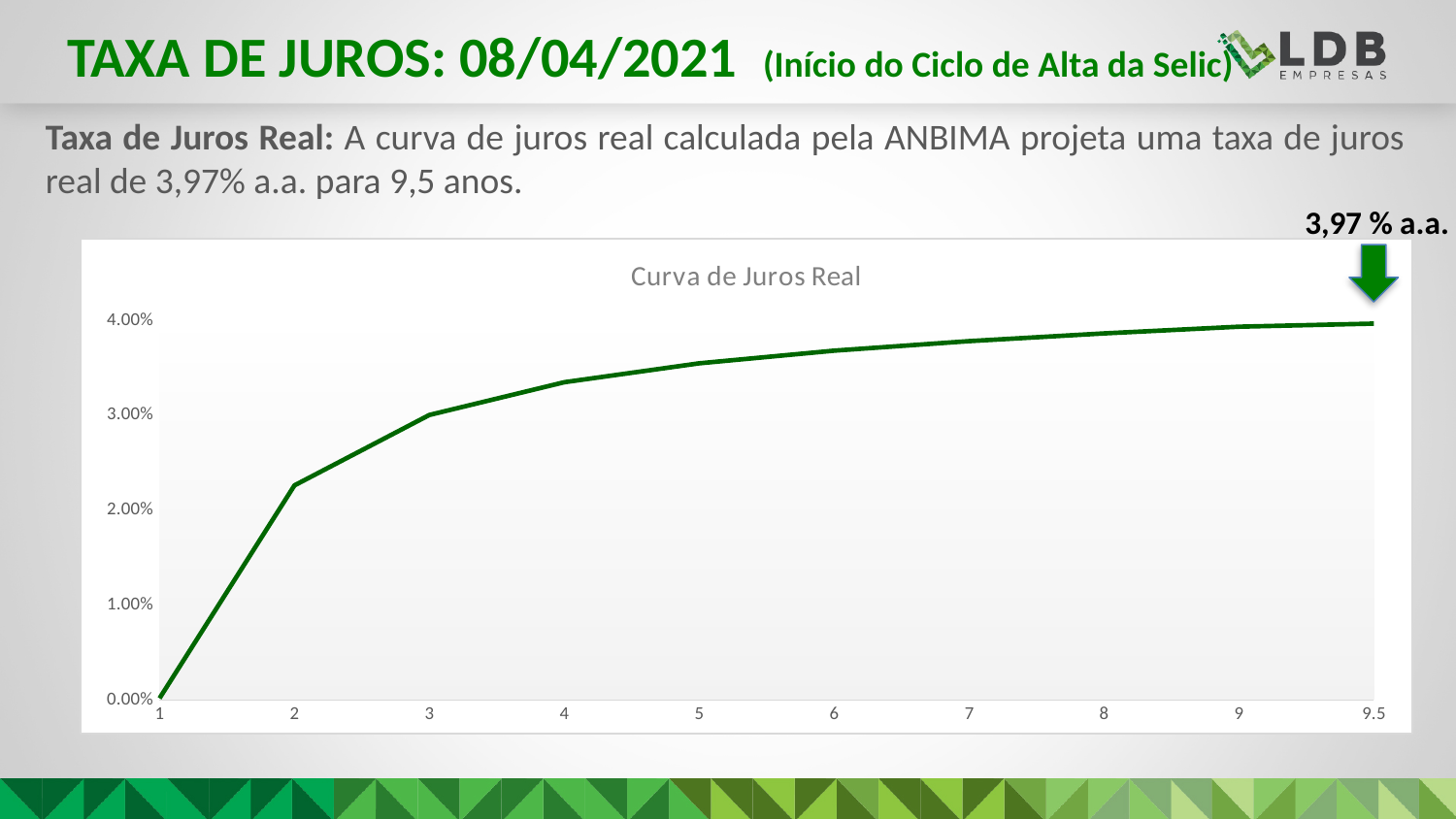
According to the annotation on the slide, what is the real interest rate at 9.5 years? 3,97 % a.a. Which is larger, the value of the curve at x = 2 or at x = 5? x = 5 At which x-axis value is the curve at its lowest point? 1 Is the value of the curve at x = 4 greater or less than 3.00%? greater How many tick labels are shown on the x axis of the chart? 10 Is the value of the curve at x = 2 greater or less than 2.00%? greater What kind of chart is shown on the slide? line chart What is the title of the chart? Curva de Juros Real Is the value of the curve at x = 1 greater or less than 1.00%? less What colour is the line plotted in the chart? green Do the values of the curve rise or fall as the x axis goes from 1 to 9.5? rise At which x-axis value does the curve reach its highest point? 9.5